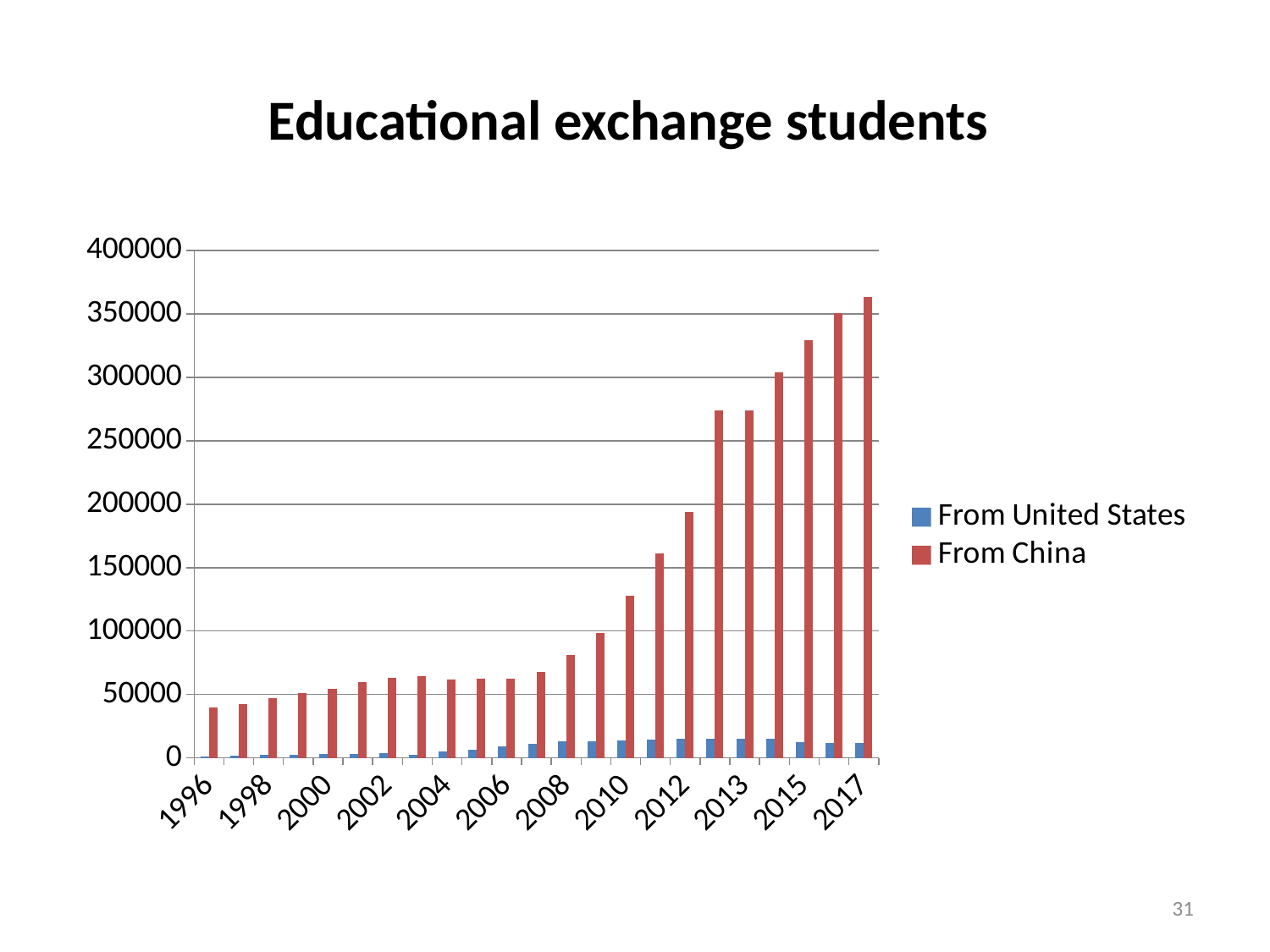
Is the 'From China' value for 2015 greater or less than 350000? less Do the 'From China' values generally rise or fall from 1996 to 2017? Rise Is the 'From China' value for 2017 greater or less than 350000? greater Which colour represents the 'From China' series? Red Which is larger in 2017, the 'From United States' value or the 'From China' value? From China Is the 'From China' value for 2010 greater or less than 100000? greater What is the title of the chart? Educational exchange students What kind of chart is shown on the slide? Bar chart In which year is the 'From China' value lowest? 1996 How many series does the legend list? 2 In which year is the 'From China' value highest? 2017